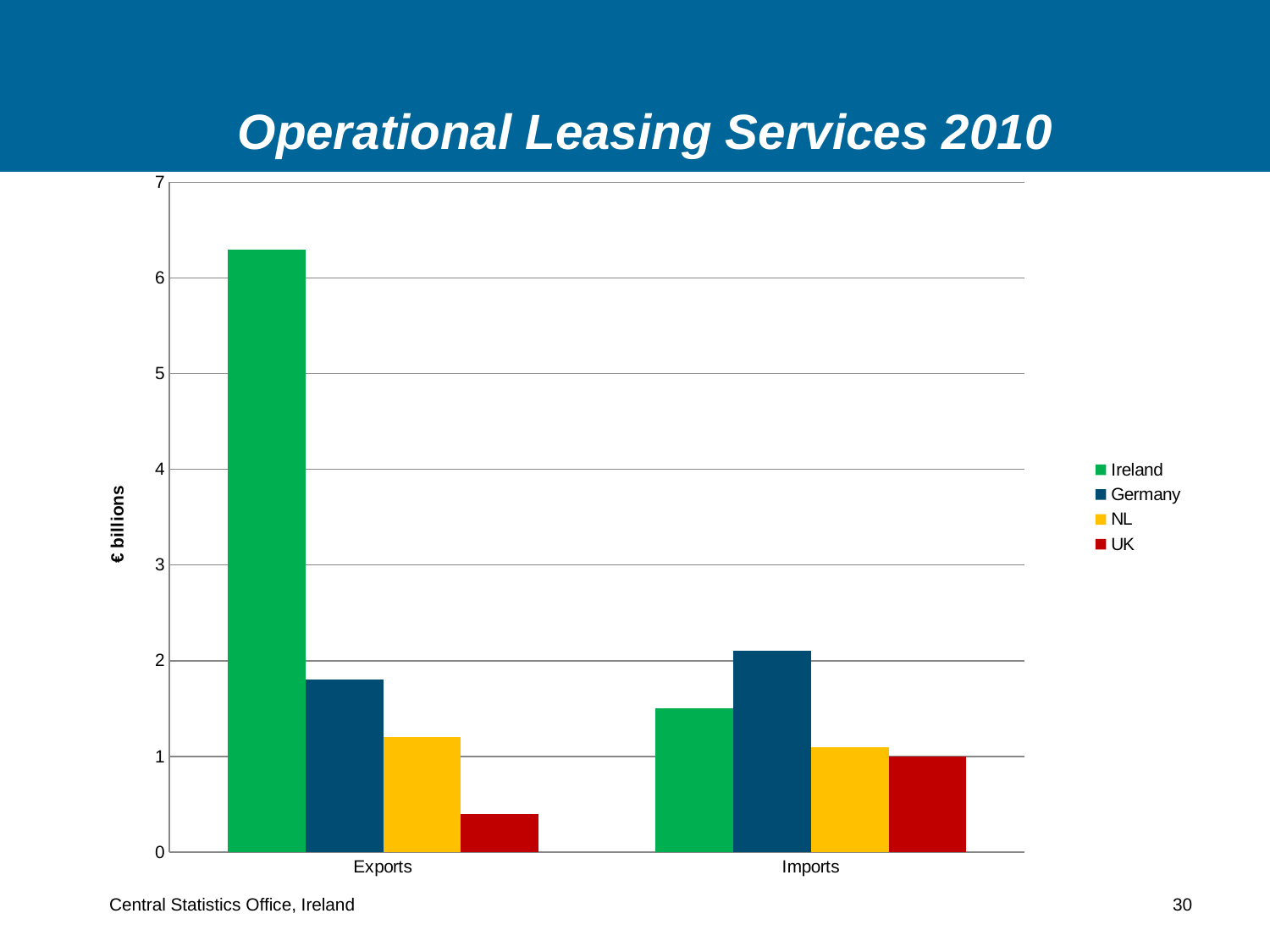
How many categories are shown on the x axis? 2 Which is larger: Germany's Exports or Germany's Imports? Imports Which country has the highest value for Exports? Ireland How many series does the legend list? 4 Is the value for UK Exports greater or less than 1? less Which country has the lowest value for Exports? UK Which country has the highest value for Imports? Germany Is the value for Ireland Exports greater or less than 6? greater What kind of chart is shown on the slide? bar chart Which is larger: Ireland's Exports or Ireland's Imports? Exports What is the label on the y axis? € billions